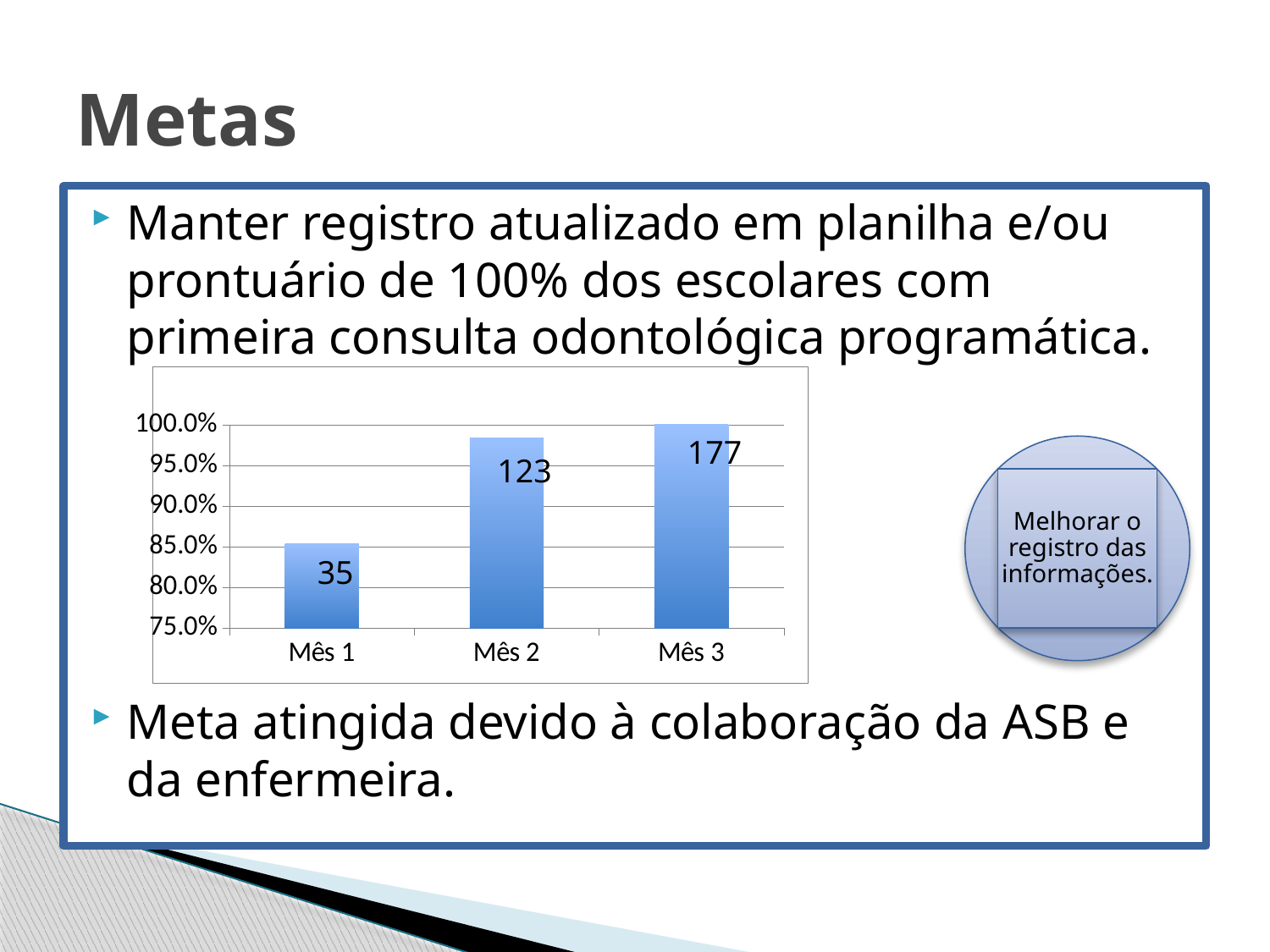
What type of chart is shown on the slide? Bar chart Which month has the shortest bar? Mês 1 What is the difference between the data labels for Mês 2 and Mês 1? 88 Is the bar for Mês 2 greater or less than 95.0% on the axis? greater How many months are shown on the x axis of the chart? 3 What data label is shown on the bar for Mês 3? 177 Which bar is taller, Mês 1 or Mês 2? Mês 2 What data label is shown on the bar for Mês 2? 123 What is the difference between the data labels for Mês 3 and Mês 1? 142 What data label is shown on the bar for Mês 1? 35 Which month has the tallest bar? Mês 3 Is the bar for Mês 1 greater or less than 90.0% on the axis? less